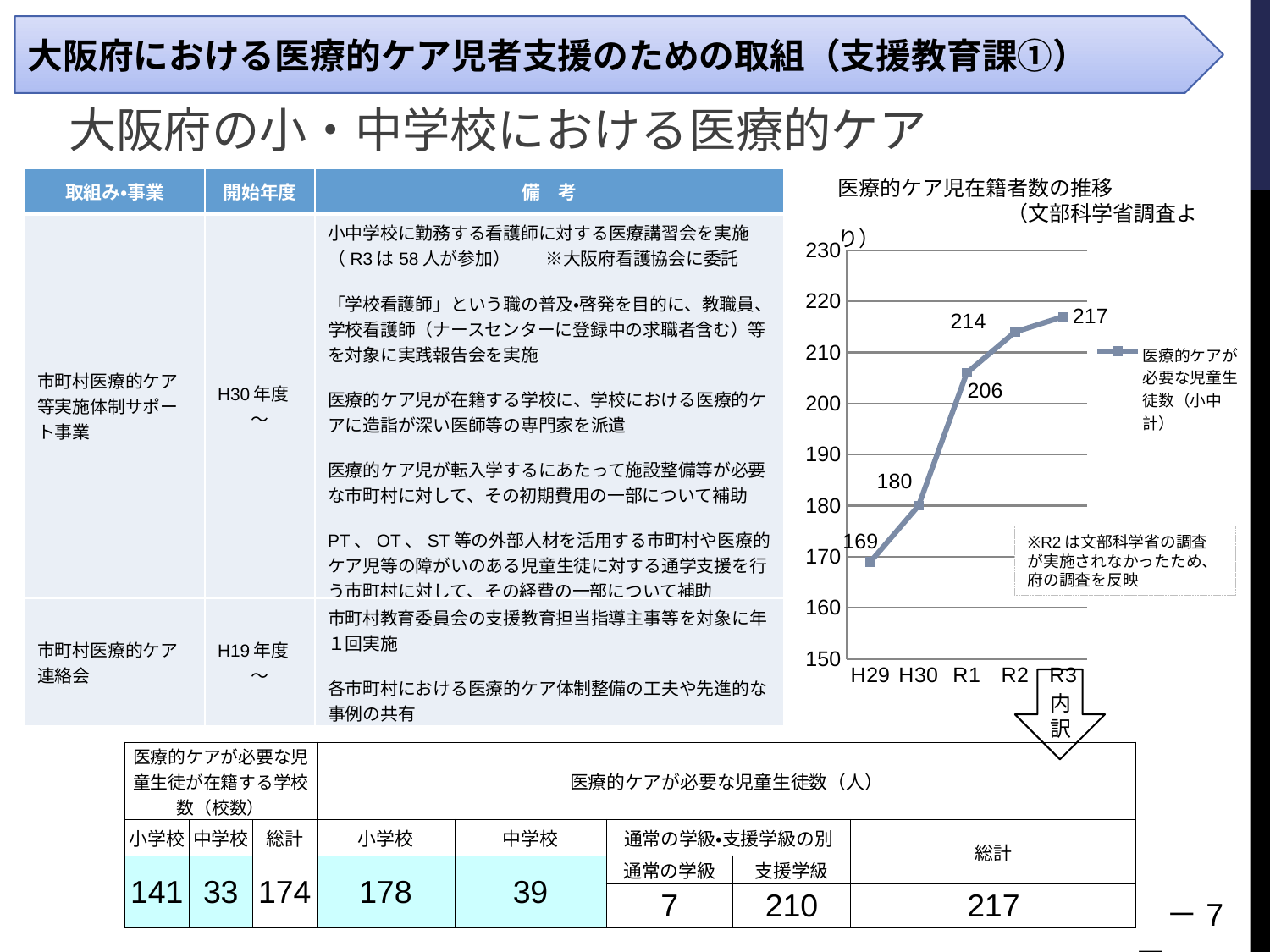
Which is larger in the line chart, the value for R2 or the value for R1? R2 What is the value for H30 in the line chart? 180 What is the difference between the values for R3 and H29 in the line chart? 48 What type of chart is shown on the slide? line chart Which year has the highest value in the line chart? R3 How many data points are plotted in the line chart? 5 What is the value for R1 in the line chart? 206 What is the difference between the values for R1 and H30 in the line chart? 26 What is the value for R3 in the line chart? 217 Do the values in the line chart rise or fall from H29 to R3? rise What is the value for H29 in the line chart? 169 Which year has the lowest value in the line chart? H29